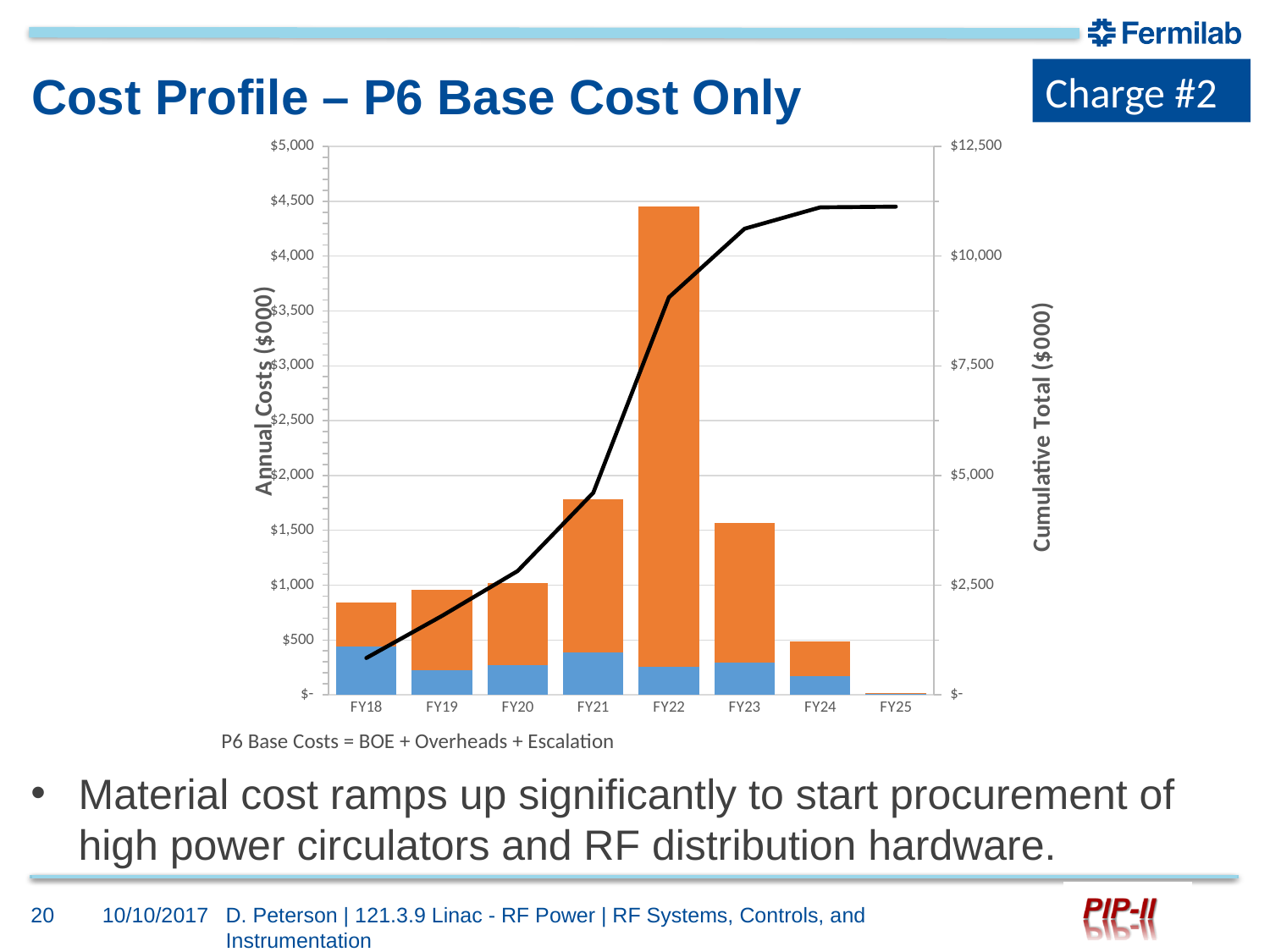
Does the cumulative total line rise or fall from FY18 to FY25? Rises Is the total annual cost bar for FY21 greater or less than $1,500? greater Is the total annual cost bar for FY22 greater or less than $4,000? greater Is the cumulative total line at FY25 greater or less than $10,000? greater Which has the larger annual cost bar, FY22 or FY23? FY22 What kind of chart is shown on the slide? Stacked bar chart with a line Which fiscal year has the highest annual cost bar? FY22 Which fiscal year has the lowest annual cost bar? FY25 How many fiscal years are shown on the x axis of the chart? 8 What is the title of the right-hand vertical axis of the chart? Cumulative Total ($000)